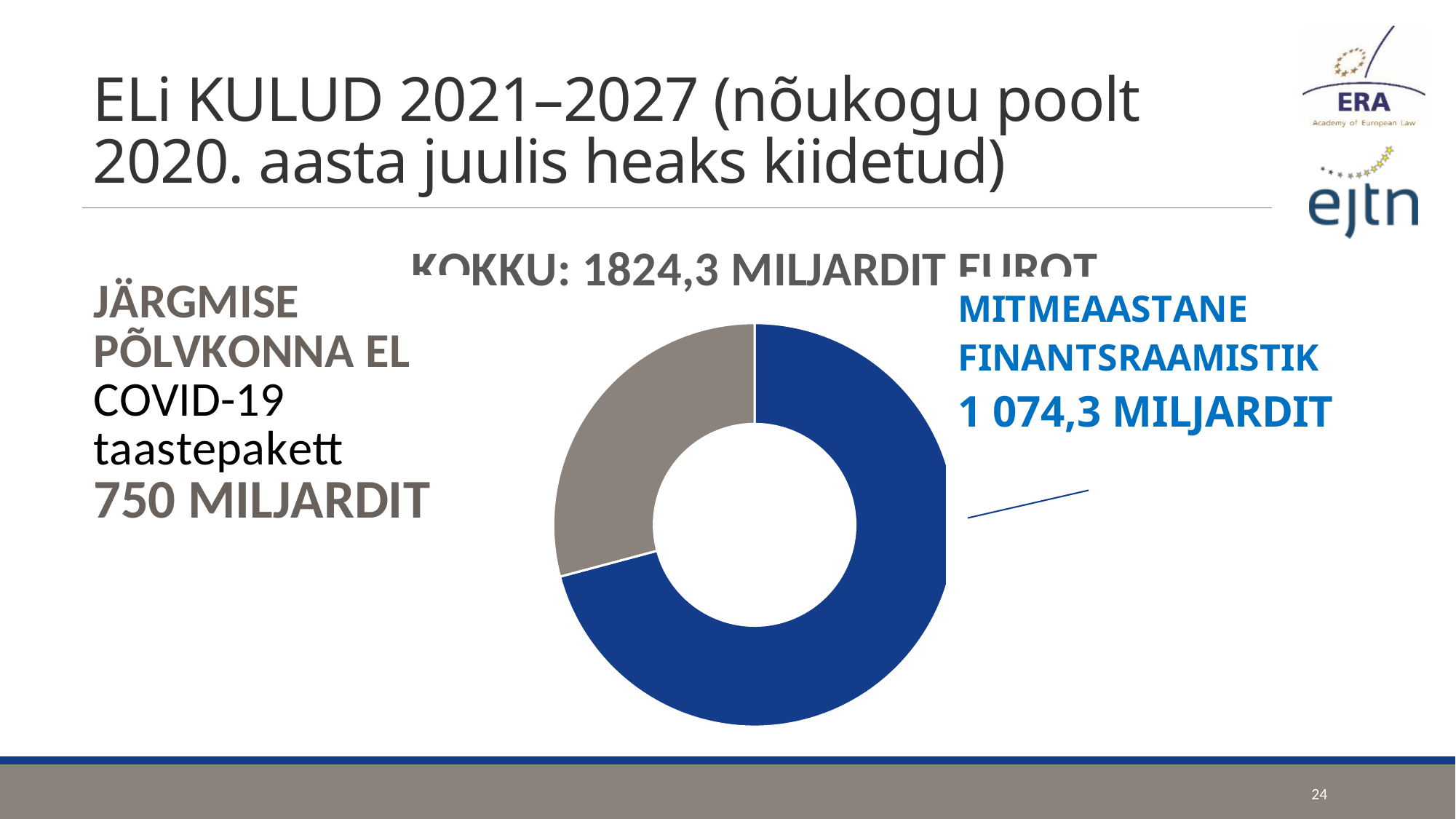
Which slice is the largest? Mitmeaastane finantsraamistik How many slices does the donut chart have? 2 Which is larger, Mitmeaastane finantsraamistik or the COVID-19 taastepakett? Mitmeaastane finantsraamistik What total (KOKKU) is shown above the chart? 1824,3 miljardit eurot What colour is the slice for the Järgmise põlvkonna EL COVID-19 taastepakett? Grey What is the value shown for Mitmeaastane finantsraamistik? 1 074,3 miljardit What is the value shown for the Järgmise põlvkonna EL COVID-19 taastepakett? 750 miljardit What is the difference between Mitmeaastane finantsraamistik (1 074,3 miljardit) and the COVID-19 taastepakett (750 miljardit)? 324,3 miljardit What kind of chart is shown on the slide? Donut (pie) chart Which slice is the smallest? Järgmise põlvkonna EL COVID-19 taastepakett What colour is the slice for Mitmeaastane finantsraamistik? Blue